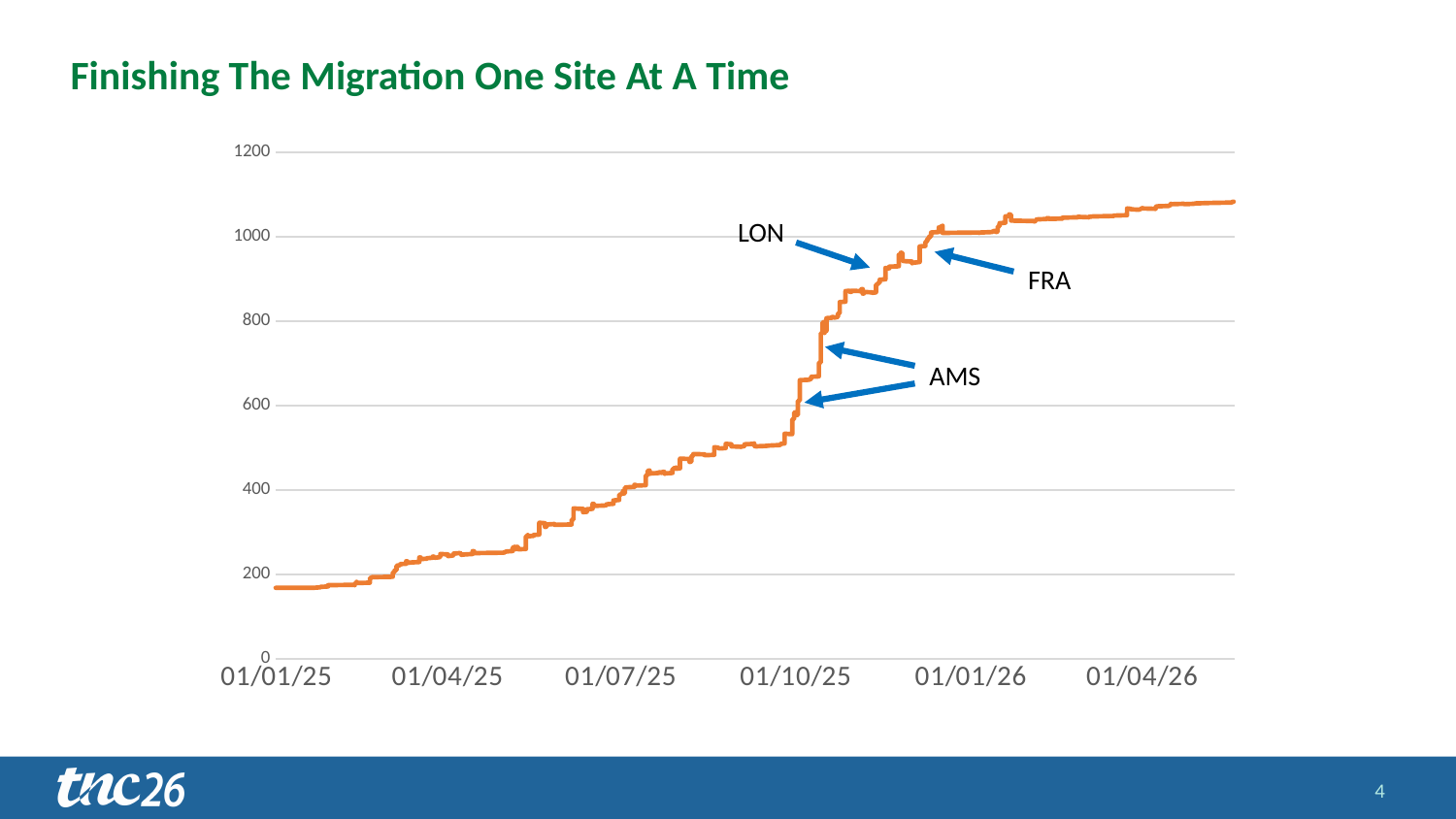
Which of the two dates has the higher value: 01/07/25 or 01/01/26? 01/01/26 How many date labels are shown on the x axis? 6 What kind of chart is shown on the slide? line chart Is the value at 01/04/25 greater or less than 400? less Is the value at 01/04/26 greater or less than 1000? greater Does the plotted line rise or fall from 01/01/25 to 01/04/26? rises What is the highest tick value shown on the y axis? 1200 Is the value at 01/01/25 greater or less than 200? less Which three site labels are annotated with arrows on the chart? LON, FRA, AMS